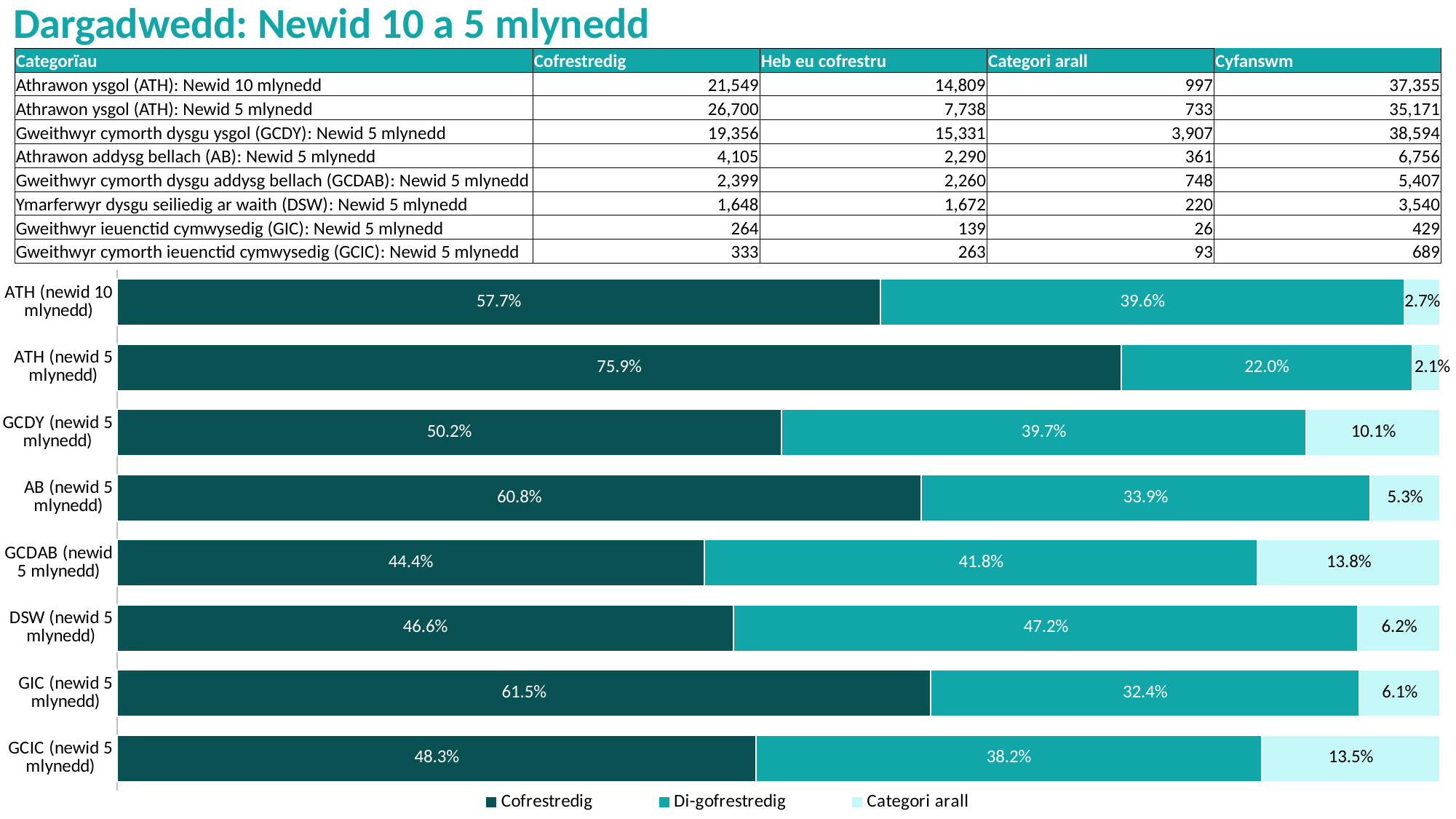
For DSW (newid 5 mlynedd) in the bar chart, which is larger: the Cofrestredig share or the Di-gofrestredig share? Di-gofrestredig What kind of chart is shown below the table? Stacked bar chart What is the Categori arall share for GCDAB (newid 5 mlynedd) in the bar chart? 13.8% How many categories are shown in the bar chart? 8 What is the Cofrestredig share for ATH (newid 5 mlynedd) in the bar chart? 75.9% How many series does the bar chart legend list? 3 Which category has the lowest Cofrestredig share in the bar chart? GCDAB (newid 5 mlynedd) What is the Di-gofrestredig share for DSW (newid 5 mlynedd) in the bar chart? 47.2% Which category has the largest Categori arall share in the bar chart? GCDAB (newid 5 mlynedd) Which category has the highest Cofrestredig share in the bar chart? ATH (newid 5 mlynedd) In the bar chart, how many percentage points higher is the Cofrestredig share for ATH (newid 5 mlynedd) than for ATH (newid 10 mlynedd)? 18.2 percentage points What are the three legend entries of the bar chart? Cofrestredig, Di-gofrestredig, Categori arall